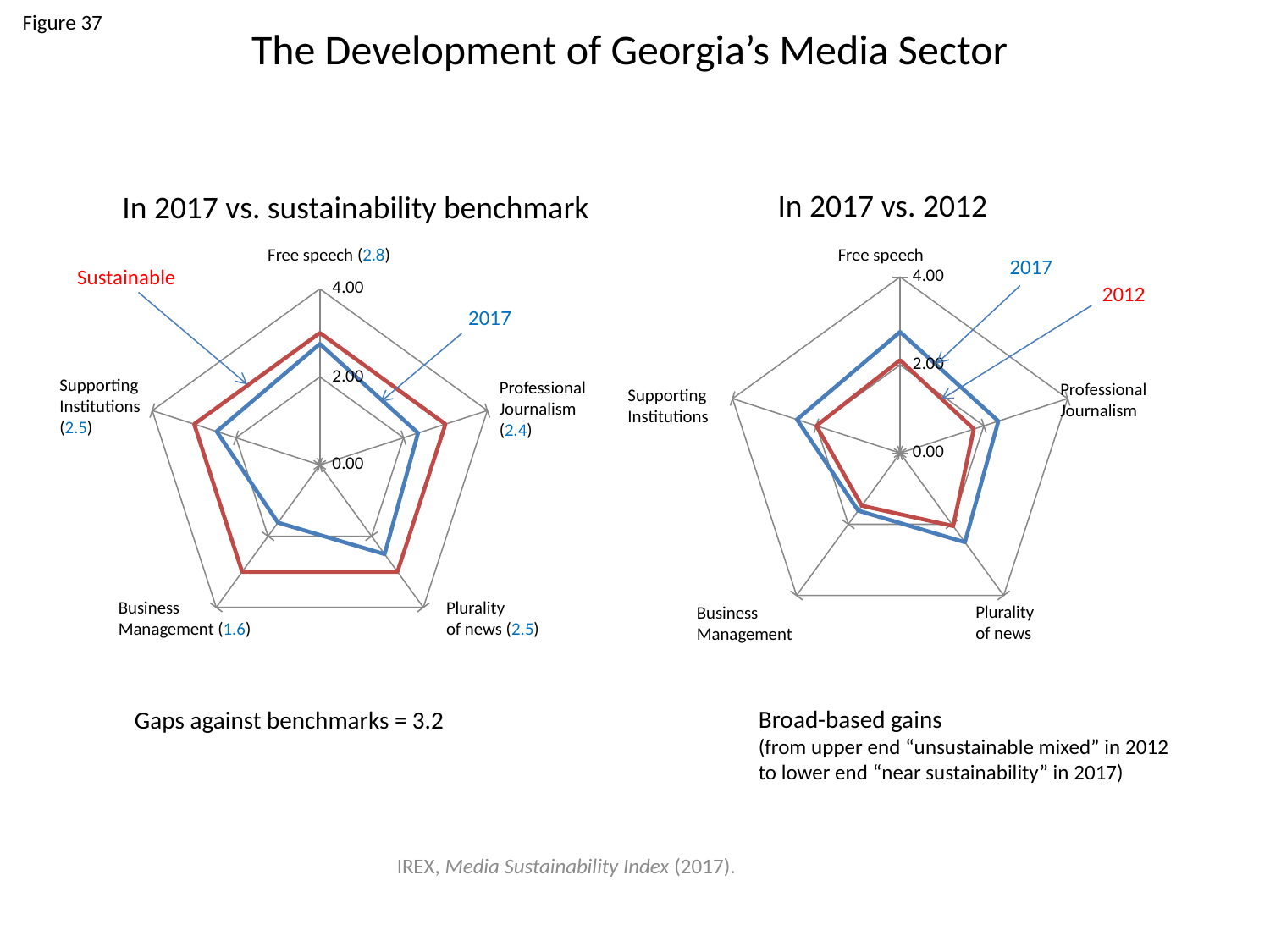
In the chart 'In 2017 vs. 2012', is the 2012 value for Business Management greater or less than 2.00? less In the chart 'In 2017 vs. sustainability benchmark', what is the difference between the 2017 values for Free speech and Business Management? 1.2 In the chart 'In 2017 vs. sustainability benchmark', which category has the highest 2017 value? Free speech In the chart 'In 2017 vs. sustainability benchmark', which has the larger 2017 value: Professional Journalism or Plurality of news? Plurality of news In the chart 'In 2017 vs. sustainability benchmark', what is the 2017 value for Business Management? 1.6 In the chart 'In 2017 vs. sustainability benchmark', which category has the lowest 2017 value? Business Management How many series are plotted in the chart 'In 2017 vs. 2012'? 2 What is the maximum value shown on the axis scale of the radar charts? 4.00 In the chart 'In 2017 vs. 2012', which series has the larger value for Plurality of news: 2017 or 2012? 2017 How many categories (axes) does each radar chart on the slide have? 5 In the chart 'In 2017 vs. sustainability benchmark', what is the 2017 value for Free speech? 2.8 What kind of chart is used on this slide for both figures? radar chart